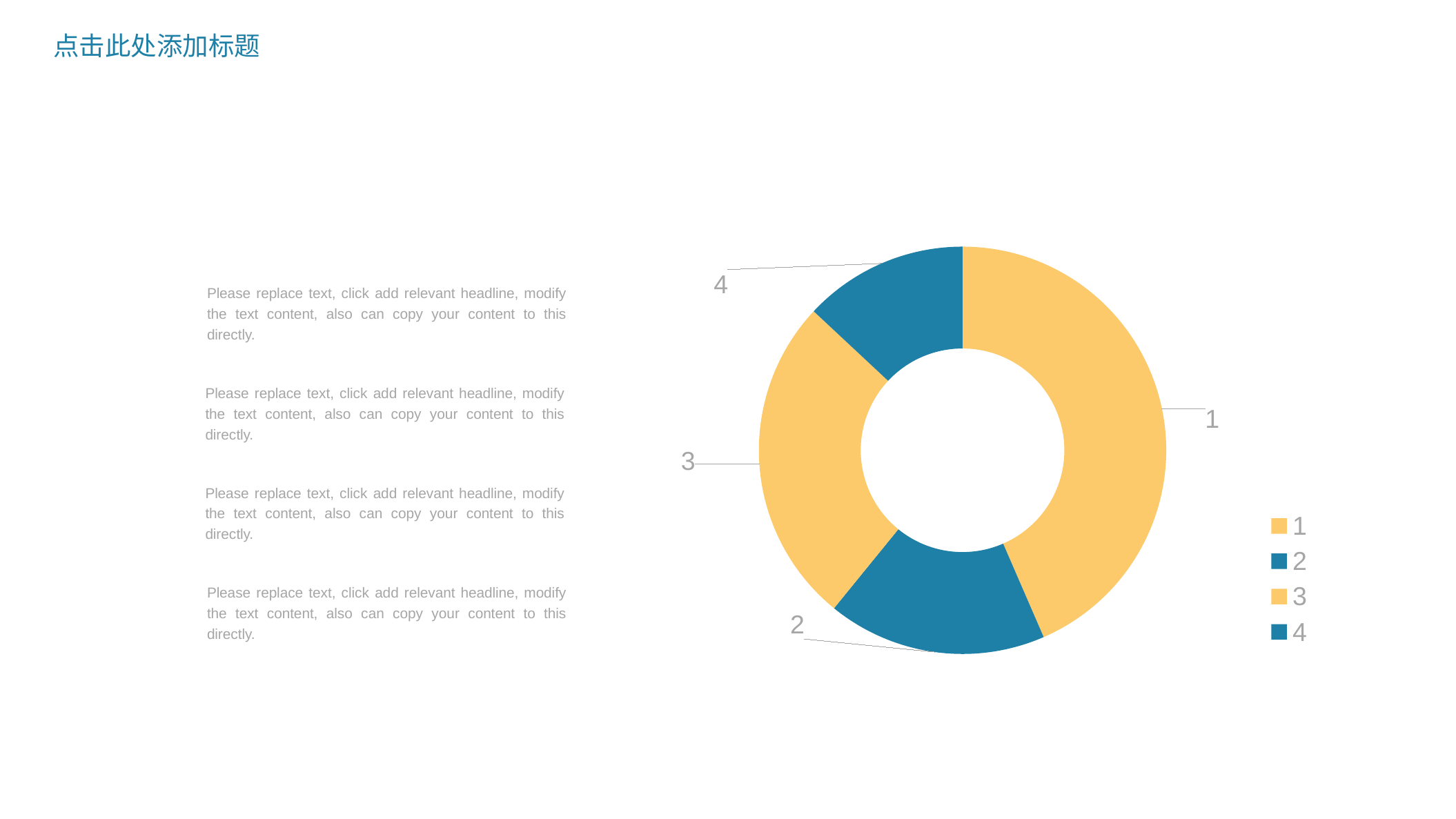
Which slice is larger, category 2 or category 4? 2 How many entries does the legend list? 4 What kind of chart is shown on the slide? doughnut chart Which slice is larger, category 1 or category 2? 1 Which slice is larger, category 1 or category 4? 1 Which category has the largest slice in the doughnut chart? 1 How many slices does the doughnut chart have? 4 What colour is the slice for category 2? blue Which category has the smallest slice in the doughnut chart? 4 What colour is the slice for category 1? yellow